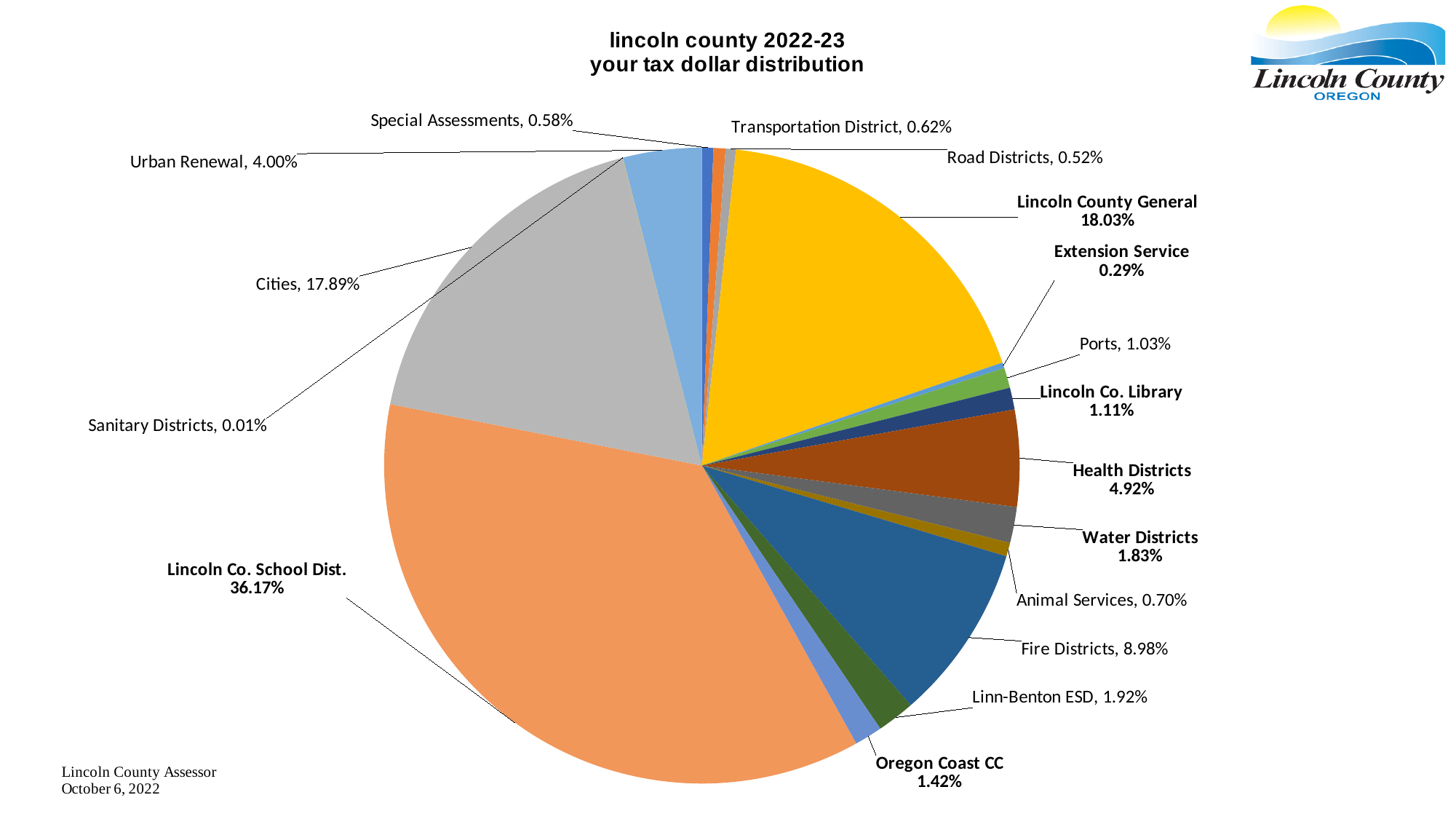
Which category has the smallest slice of the pie? Sanitary Districts What percentage is shown for Health Districts? 4.92% What share of the tax dollar goes to Lincoln Co. School Dist.? 36.17% Which is larger, Urban Renewal or Water Districts? Urban Renewal What is the difference in percentage points between Lincoln Co. School Dist. and Lincoln County General? 18.14 What percentage is shown for Fire Districts? 8.98% How many slices does the pie chart have? 17 What kind of chart is shown on the slide? pie chart Which is larger, Lincoln County General or Cities? Lincoln County General What is the title of the chart? lincoln county 2022-23 your tax dollar distribution What is the difference in percentage points between Fire Districts and Health Districts? 4.06 Which category has the largest slice of the pie? Lincoln Co. School Dist.